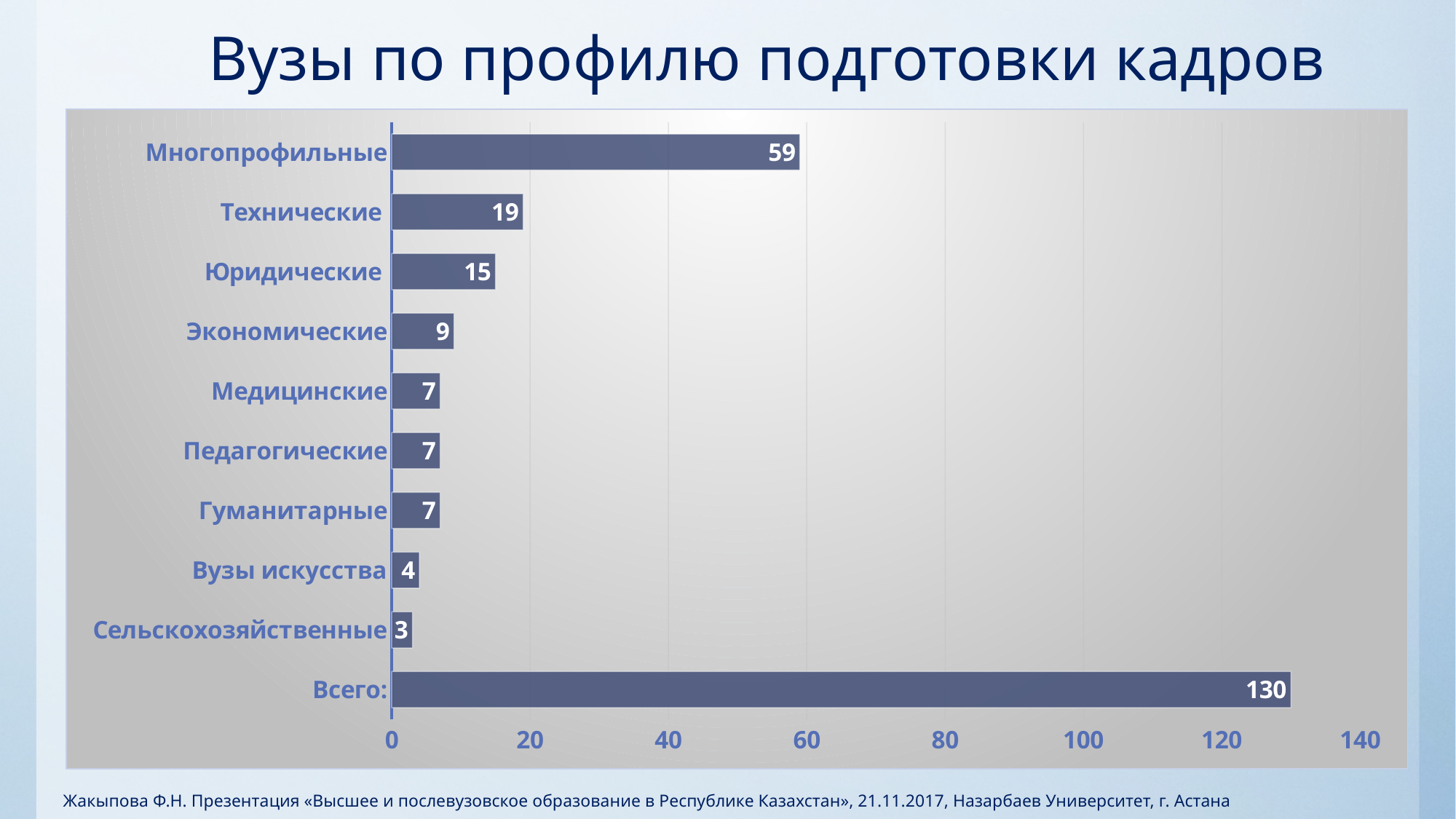
What kind of chart is shown on the slide? bar chart What is the title of the slide? Вузы по профилю подготовки кадров Is the value for Всего: greater or less than 120? greater Which is larger, the value for Экономические or the value for Медицинские? Экономические What is the value for Многопрофильные? 59 What is the difference between the values for Многопрофильные and Технические? 40 What is the value shown for Всего:? 130 Which category has the lowest value? Сельскохозяйственные What is the value for Технические? 19 Excluding the Всего: bar, which category has the highest value? Многопрофильные What is the value for Юридические? 15 How many bars are shown in the chart? 10